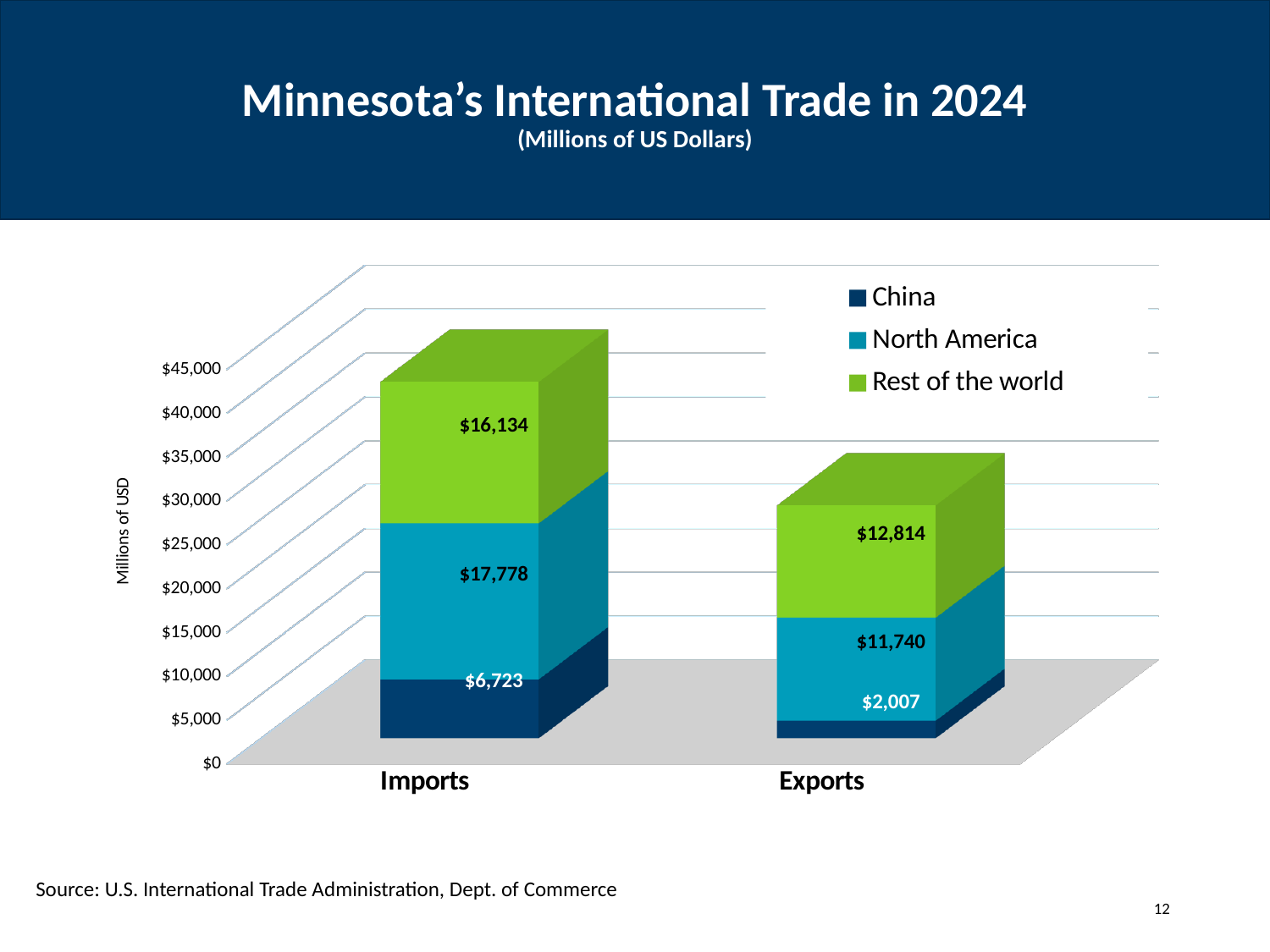
What is the value for China in the Exports bar? $2,007 How many series does the legend list? 3 What is the value for North America in the Exports bar? $11,740 What is the value for Rest of the world in the Imports bar? $16,134 Which is larger: the Rest of the world value for Imports or the Rest of the world value for Exports? Imports What is the value for China in the Imports bar? $6,723 What is the total of the Exports stacked bar? $26,561 What kind of chart is shown on the slide? Stacked bar chart Which series has the smallest value in the Exports bar? China What is the total of the Imports stacked bar? $40,635 What is the difference between the North America value for Imports and the North America value for Exports? $6,038 Which series has the largest value in the Imports bar? North America